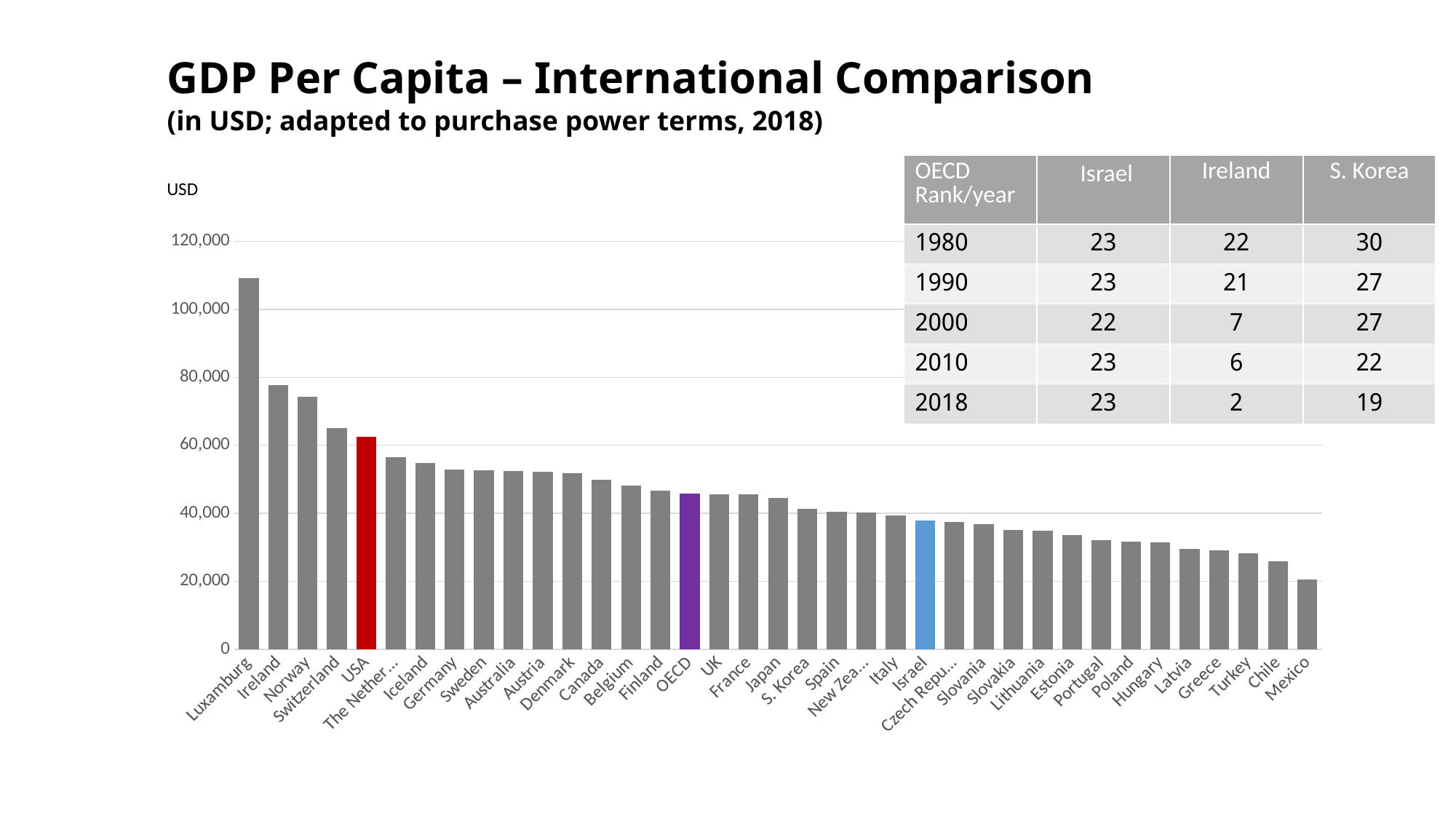
Do the bar values rise or fall from left to right along the x axis? fall Is the value for Norway greater or less than 80,000? less Is the value for USA greater or less than 60,000? greater Which bar in the chart is coloured red? USA Is the value for Luxamburg greater or less than 100,000? greater Which country has the lowest GDP per capita in the chart? Mexico Which has a higher GDP per capita, USA or Israel? USA Which country has the highest GDP per capita in the chart? Luxamburg Which has a higher GDP per capita, Ireland or Norway? Ireland What kind of chart is shown on the slide? bar chart